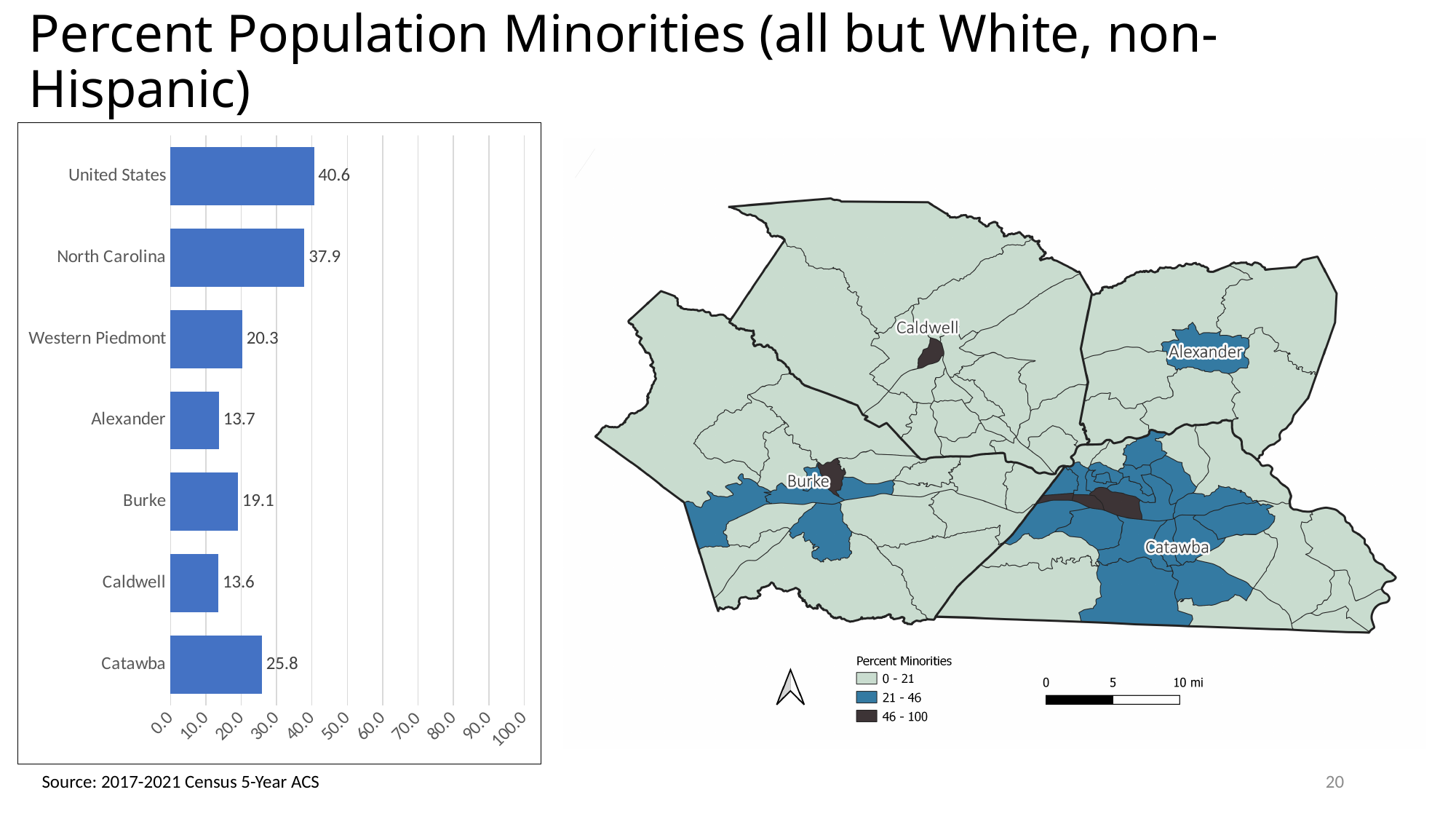
What is the value for Catawba in the bar chart? 25.8 What kind of chart is shown on the left of the slide? bar chart What is the difference between the values for Catawba and Burke in the bar chart? 6.7 What is the value for Burke in the bar chart? 19.1 What is the value for Western Piedmont in the bar chart? 20.3 How many categories are shown in the bar chart? 7 What is the value for United States in the bar chart? 40.6 What is the difference between the values for United States and North Carolina in the bar chart? 2.7 How many ranges does the map legend for Percent Minorities list? 3 Which category has the highest value in the bar chart? United States In the bar chart, is the value for Alexander greater or less than 20.0? less In the bar chart, which is larger, the value for Catawba or the value for Burke? Catawba